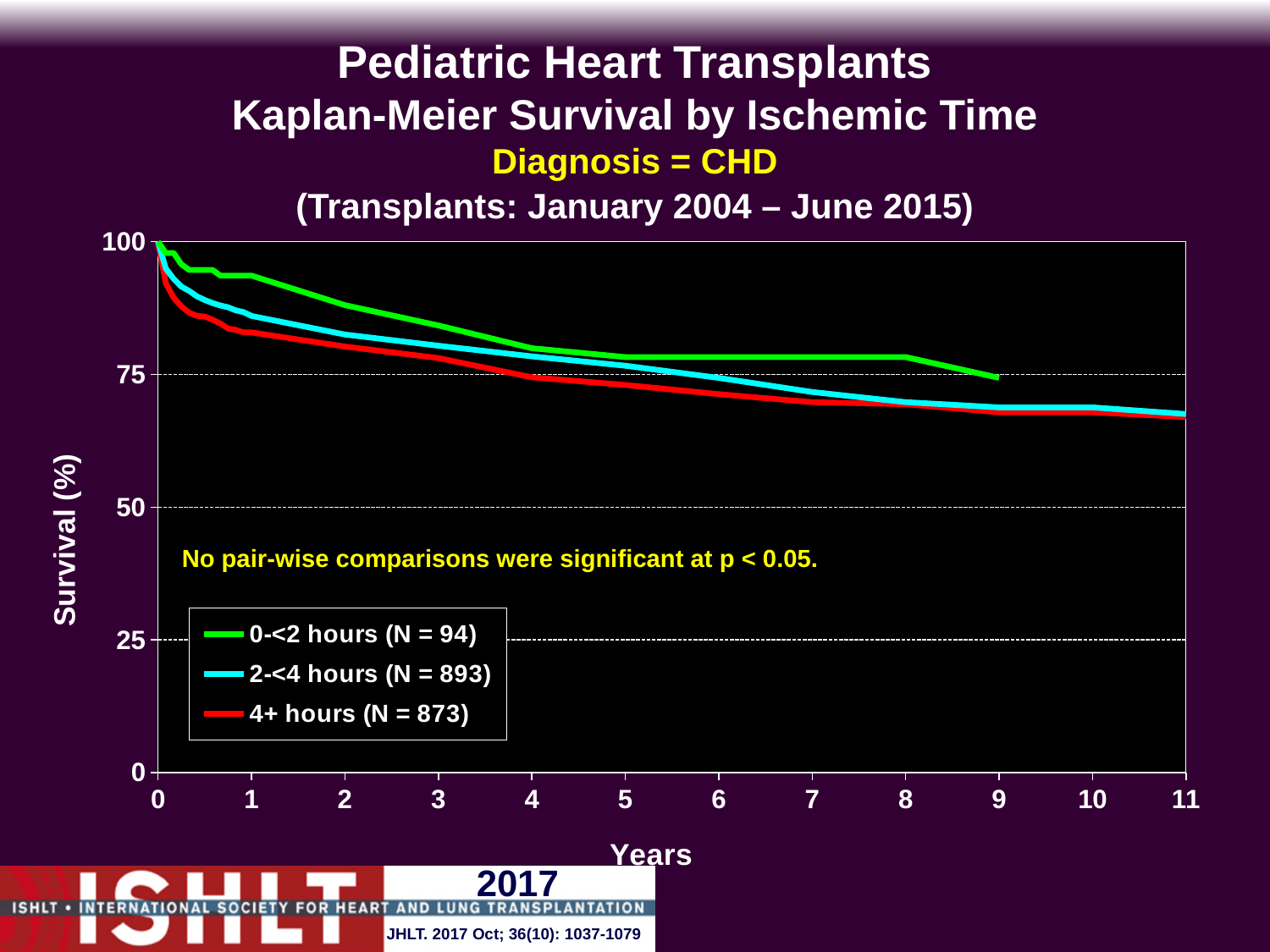
Which ischemic time group has the lowest survival at year 3? 4+ hours What kind of chart is shown on the slide? Line chart At year 6, is survival higher for the 0-<2 hours group or the 4+ hours group? 0-<2 hours Up to what year does the x axis extend? 11 Is the survival for the 2-<4 hours group at year 1 greater or less than 75? greater Which ischemic time group has the highest survival at year 5? 0-<2 hours Do the survival curves rise or fall as years increase? Fall How many series does the legend list? 3 Is the survival for the 4+ hours group at year 11 greater or less than 75? less What is the label of the y axis? Survival (%) Is the survival for the 0-<2 hours group at year 5 greater or less than 75? greater What is the N for the 2-<4 hours group shown in the legend? 893